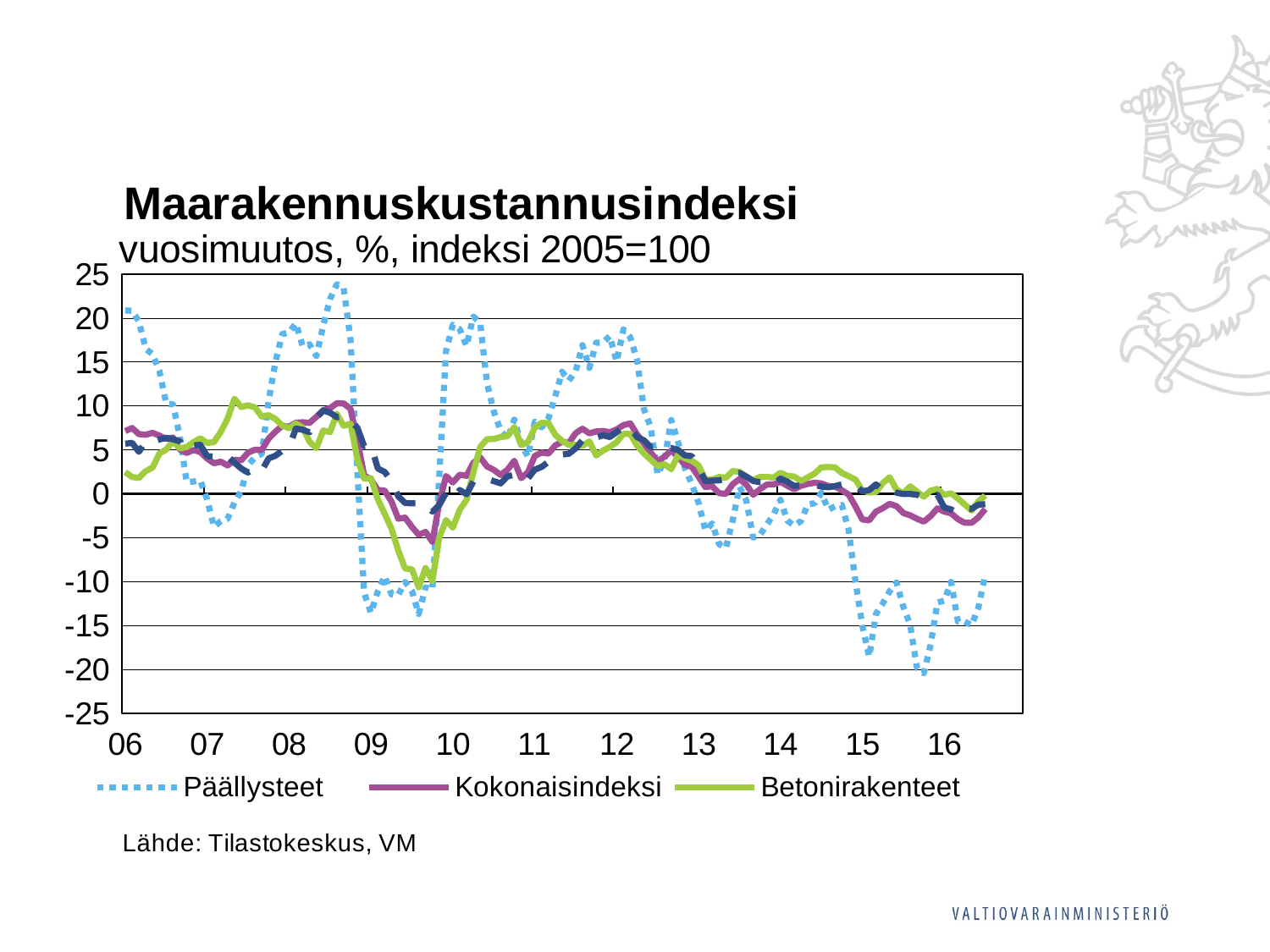
How many series does the legend list? 3 What is the title of the chart? Maarakennuskustannusindeksi Is the lowest value of Päällysteet in 2015 greater or less than -10? less Is the peak value of Päällysteet around 2008–2009 greater or less than 20? greater Is the value of Kokonaisindeksi at the start of 2016 greater or less than 0? less How many year labels are shown on the x axis? 11 Does Kokonaisindeksi generally rise or fall between 2012 and 2016? fall What kind of chart is shown on the slide? line chart Which series is drawn with a dotted light blue line according to the legend? Päällysteet Which series reaches the highest value anywhere on the chart? Päällysteet Which series reaches the lowest value anywhere on the chart? Päällysteet